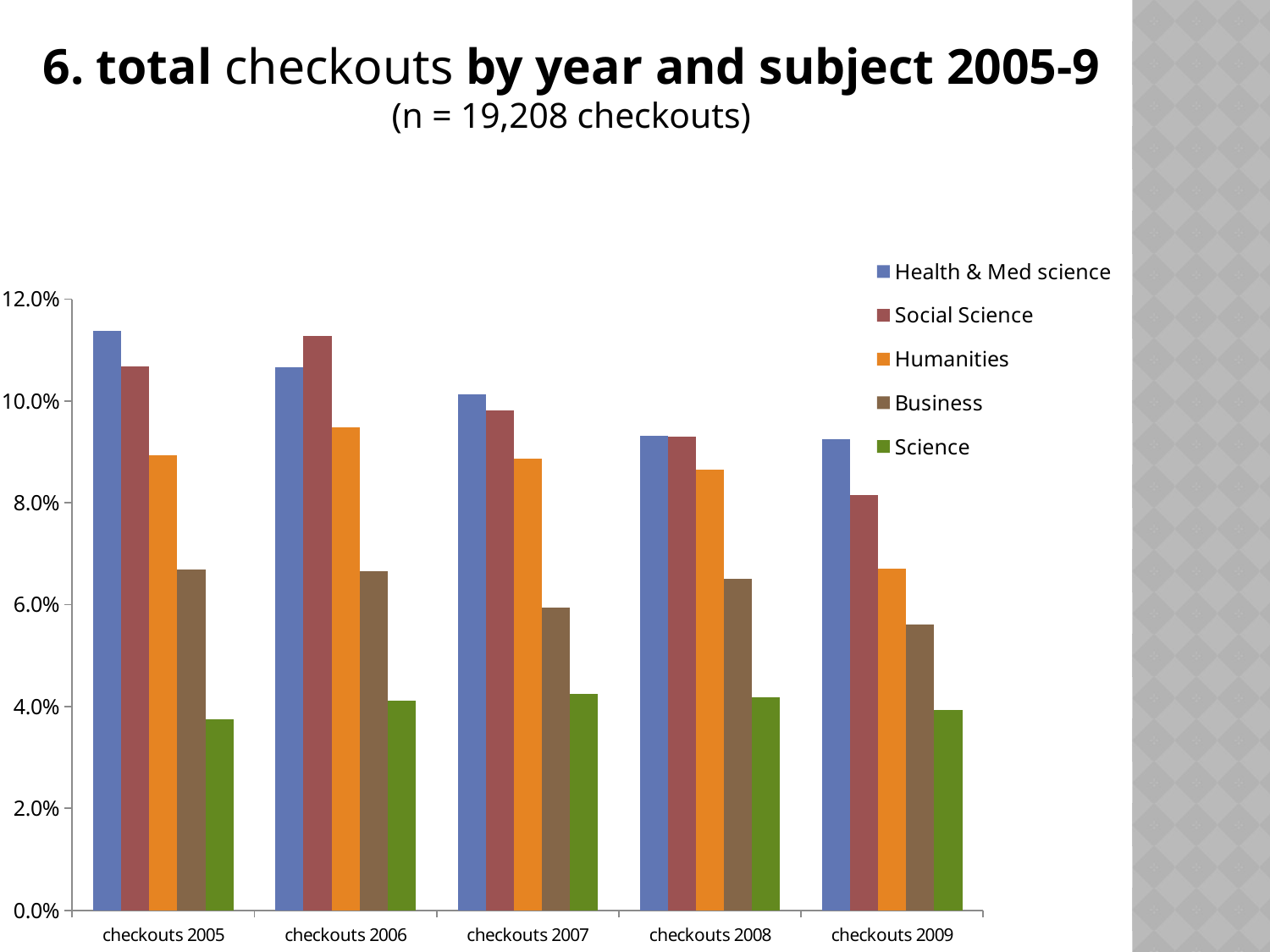
Which subject has the highest value for checkouts 2006? Social Science How many year categories are shown along the x axis? 5 How many series does the legend list? 5 Is the value for Business in checkouts 2009 greater or less than 6.0%? less What colour represents Science in the legend? green Does the Social Science value rise or fall from checkouts 2006 to checkouts 2009? fall For checkouts 2009, which is larger: Humanities or Business? Humanities Which subject has the lowest value for checkouts 2005? Science Is the value for Science in checkouts 2005 greater or less than 4.0%? less Is the value for Humanities in checkouts 2006 greater or less than 8.0%? greater For checkouts 2005, which is larger: Health & Med science or Social Science? Health & Med science What kind of chart is shown on the slide? bar chart